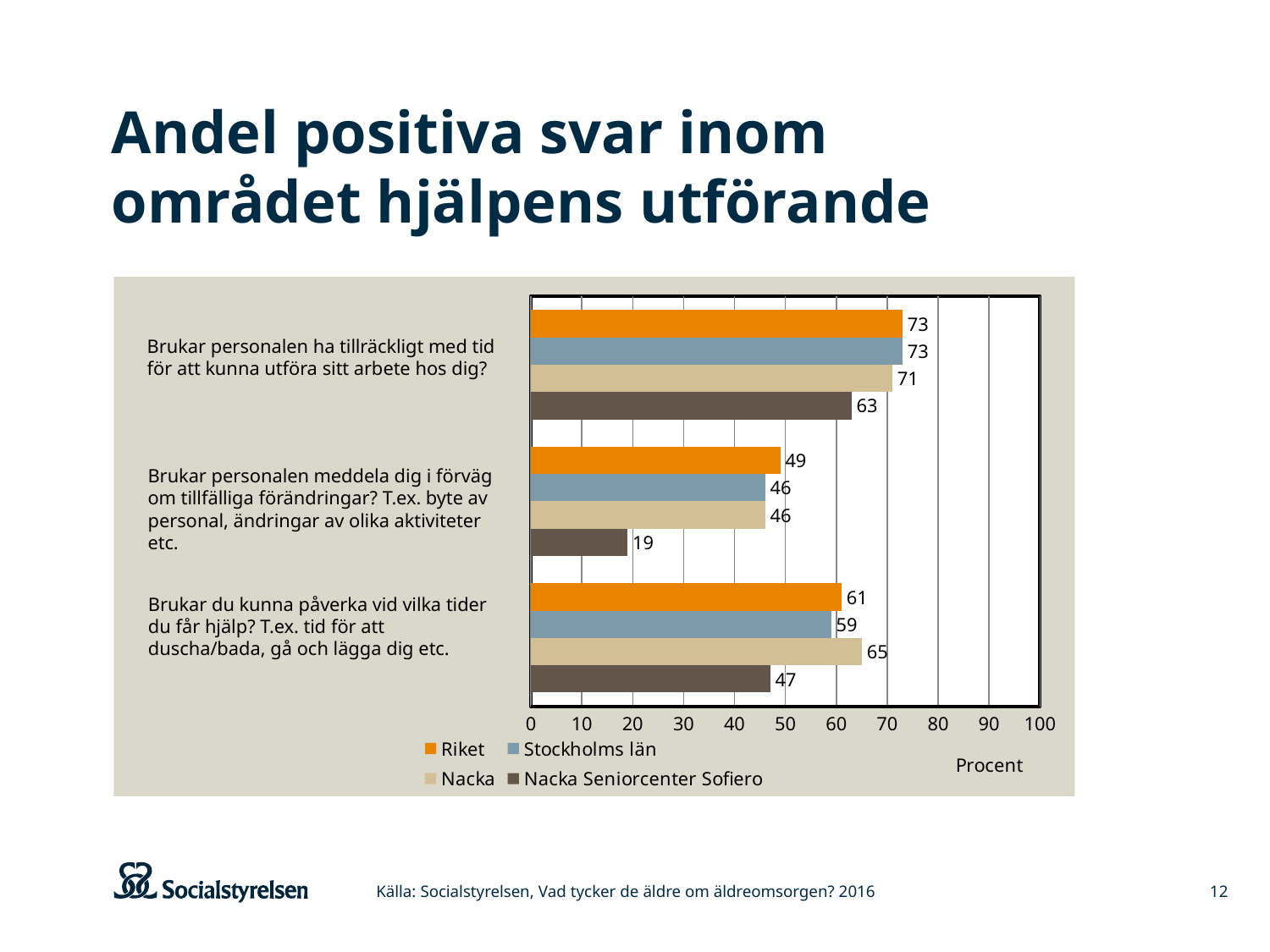
What is the value for Riket on the question "Brukar personalen ha tillräckligt med tid för att kunna utföra sitt arbete hos dig?"? 73 What is the label on the horizontal axis of the chart? Procent What is the value for Stockholms län on the question "Brukar du kunna påverka vid vilka tider du får hjälp?"? 59 Which series has the highest value on the question "Brukar du kunna påverka vid vilka tider du får hjälp?"? Nacka What is the value for Nacka on the question "Brukar du kunna påverka vid vilka tider du får hjälp?"? 65 What is the value for Nacka Seniorcenter Sofiero on the question "Brukar personalen meddela dig i förväg om tillfälliga förändringar?"? 19 How many questions (categories) are shown on the chart? 3 What kind of chart is shown on the slide? Bar chart How many series does the legend list? 4 What is the difference between Riket and Nacka Seniorcenter Sofiero on the question "Brukar personalen meddela dig i förväg om tillfälliga förändringar?"? 30 Which is larger on the question "Brukar personalen ha tillräckligt med tid för att kunna utföra sitt arbete hos dig?": Nacka or Nacka Seniorcenter Sofiero? Nacka Which series has the lowest value on the question "Brukar personalen meddela dig i förväg om tillfälliga förändringar?"? Nacka Seniorcenter Sofiero